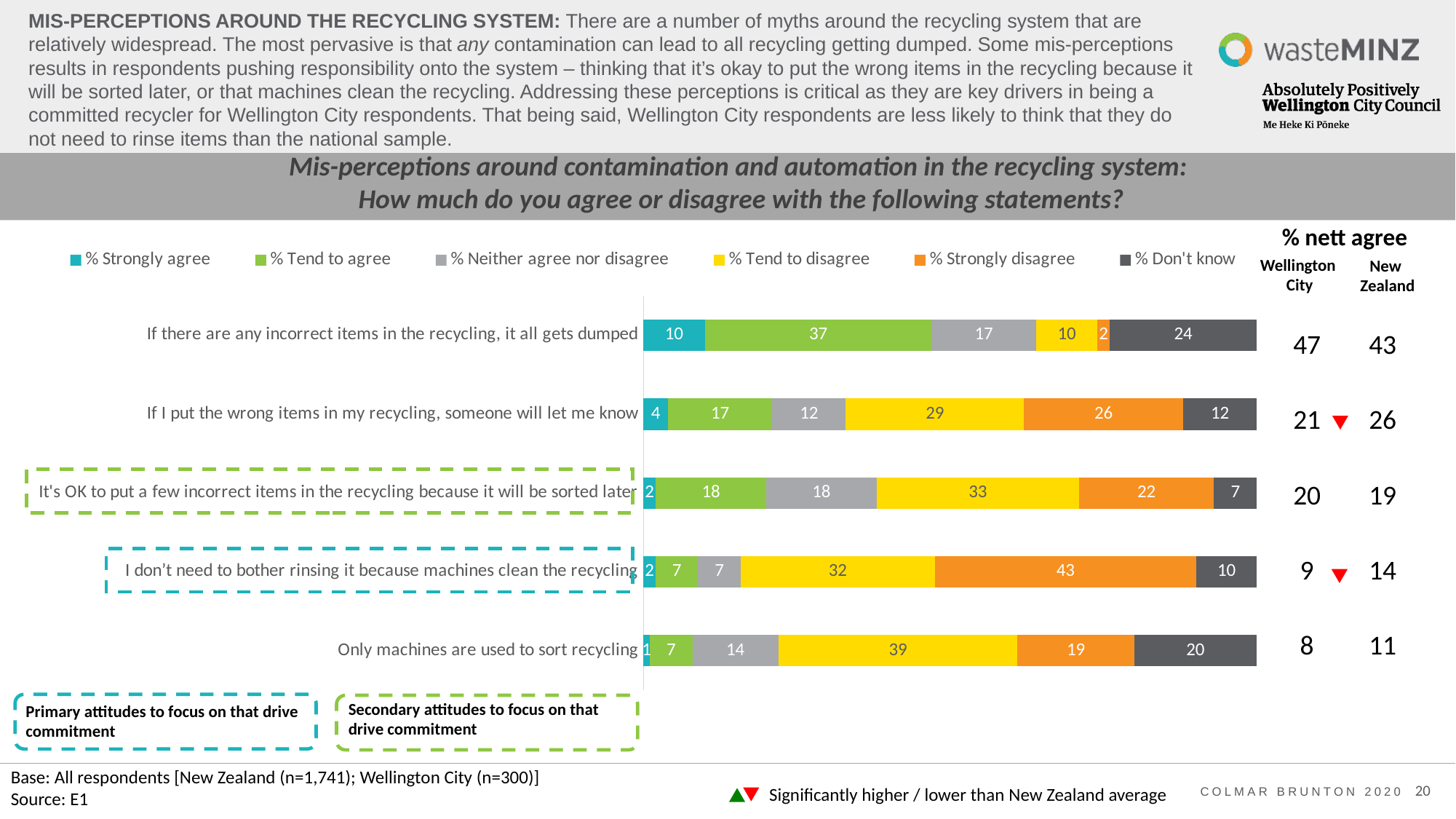
What is the % Tend to disagree value for 'Only machines are used to sort recycling'? 39 What is the % Strongly disagree value for 'I don't need to bother rinsing it because machines clean the recycling'? 43 Which statement has the lowest % Strongly agree value? Only machines are used to sort recycling What is the % Tend to agree value for 'If there are any incorrect items in the recycling, it all gets dumped'? 37 Which is larger: the % Tend to disagree value for 'If I put the wrong items in my recycling, someone will let me know' or for 'It's OK to put a few incorrect items in the recycling because it will be sorted later'? It's OK to put a few incorrect items in the recycling because it will be sorted later Which statement has the highest % Strongly disagree value? I don't need to bother rinsing it because machines clean the recycling What kind of chart is shown on the slide? Stacked bar chart What is the difference between the % Don't know values for 'If there are any incorrect items in the recycling, it all gets dumped' and 'It's OK to put a few incorrect items in the recycling because it will be sorted later'? 17 What is the % nett agree value for Wellington City for 'If there are any incorrect items in the recycling, it all gets dumped'? 47 How many statements are plotted in the chart? 5 How many series does the chart legend list? 6 Which colour represents % Strongly disagree in the chart legend? Orange